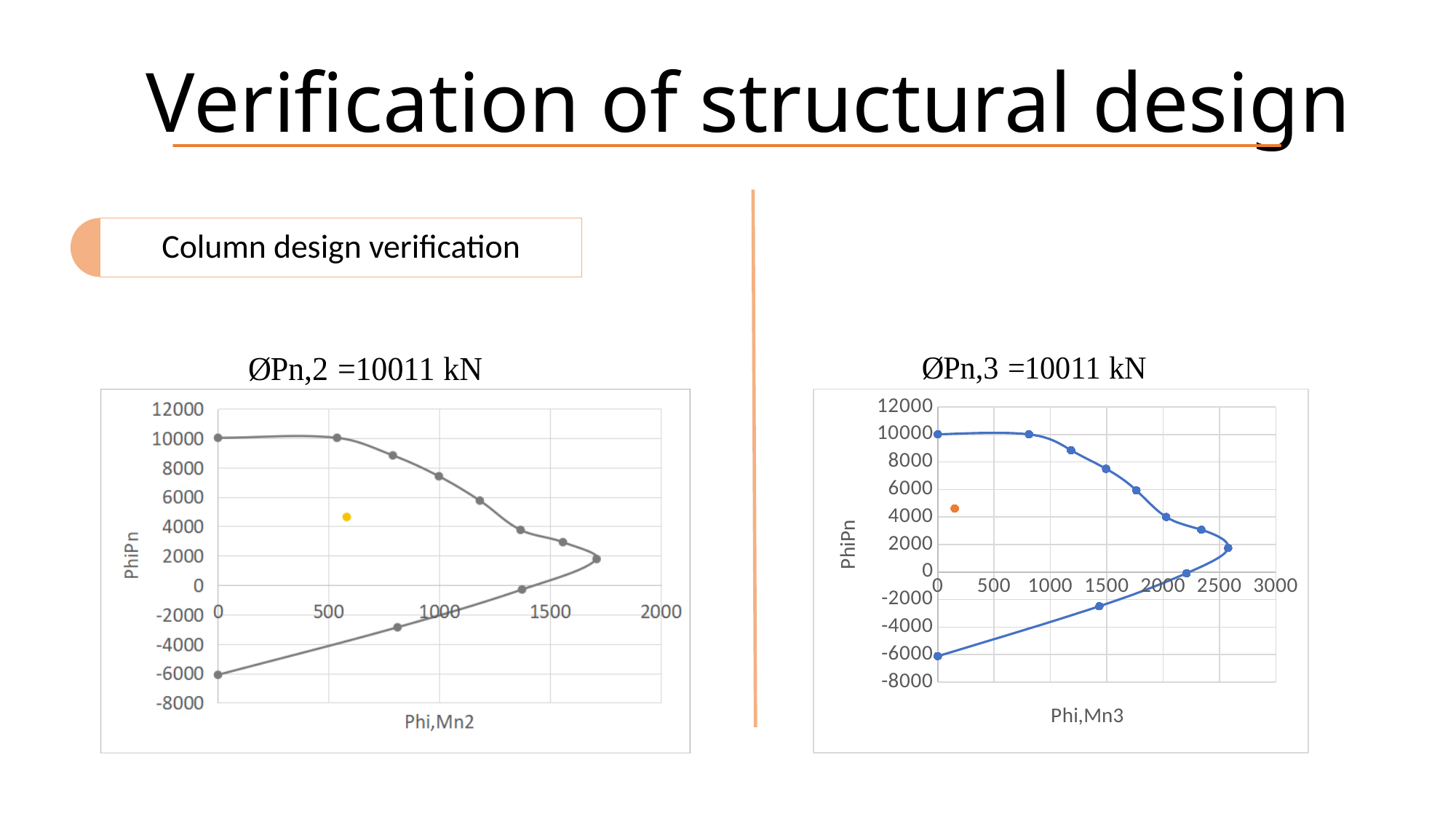
What kind of chart is the left chart titled "ØPn,2 =10011 kN"? scatter chart What is the title of the right chart? ØPn,3 =10011 kN In the right chart (ØPn,3), is the PhiPn value of the orange point greater or less than 4000? greater In the left chart (ØPn,2), is the PhiPn value of the curve at Phi,Mn2 = 0 on the upper branch greater or less than 8000? greater Which chart's curve reaches a larger maximum value on the horizontal axis, the left chart (ØPn,2) or the right chart (ØPn,3)? the right chart (ØPn,3) In the left chart (ØPn,2), is the PhiPn value of the yellow point greater or less than 4000? greater In the right chart (ØPn,3), along the upper branch of the curve, does PhiPn rise or fall as Phi,Mn3 increases from 0 to 2500? fall What is the x-axis title of the left chart? Phi,Mn2